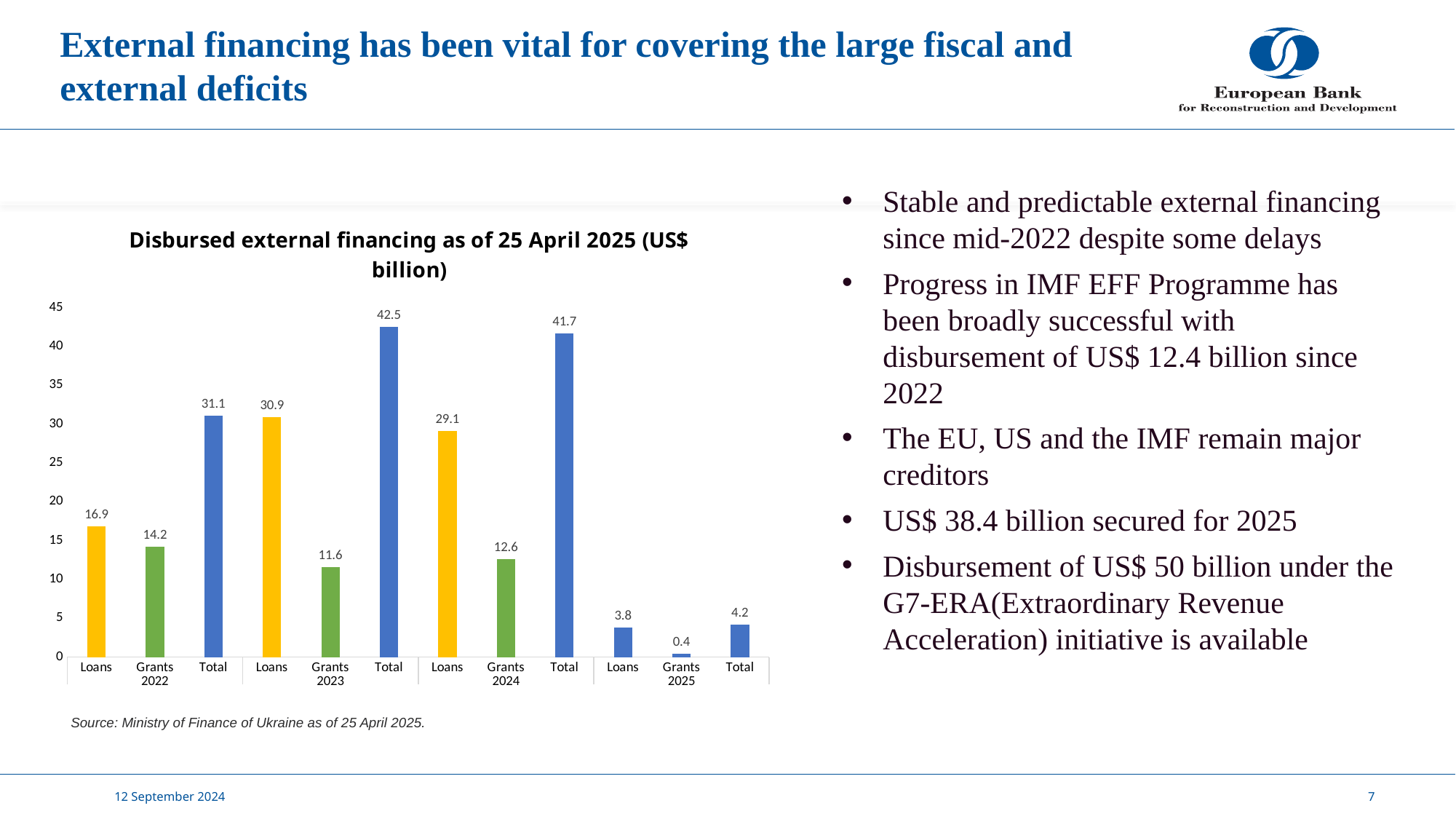
Which is larger, Loans in 2022 or Loans in 2023? Loans in 2023 What is the Total for 2024? 41.7 What is the difference between Loans and Grants in 2024? 16.5 Which year has the lowest Loans value? 2025 Which year has the highest Total? 2023 Is the Total for 2022 greater or less than 30? greater What is the value of Grants for 2023? 11.6 What kind of chart is shown on the slide? Bar chart What is the value of Grants for 2025? 0.4 What is the value of Loans for 2022? 16.9 How many bars are plotted in the chart? 12 What is the title of the chart? Disbursed external financing as of 25 April 2025 (US$ billion)